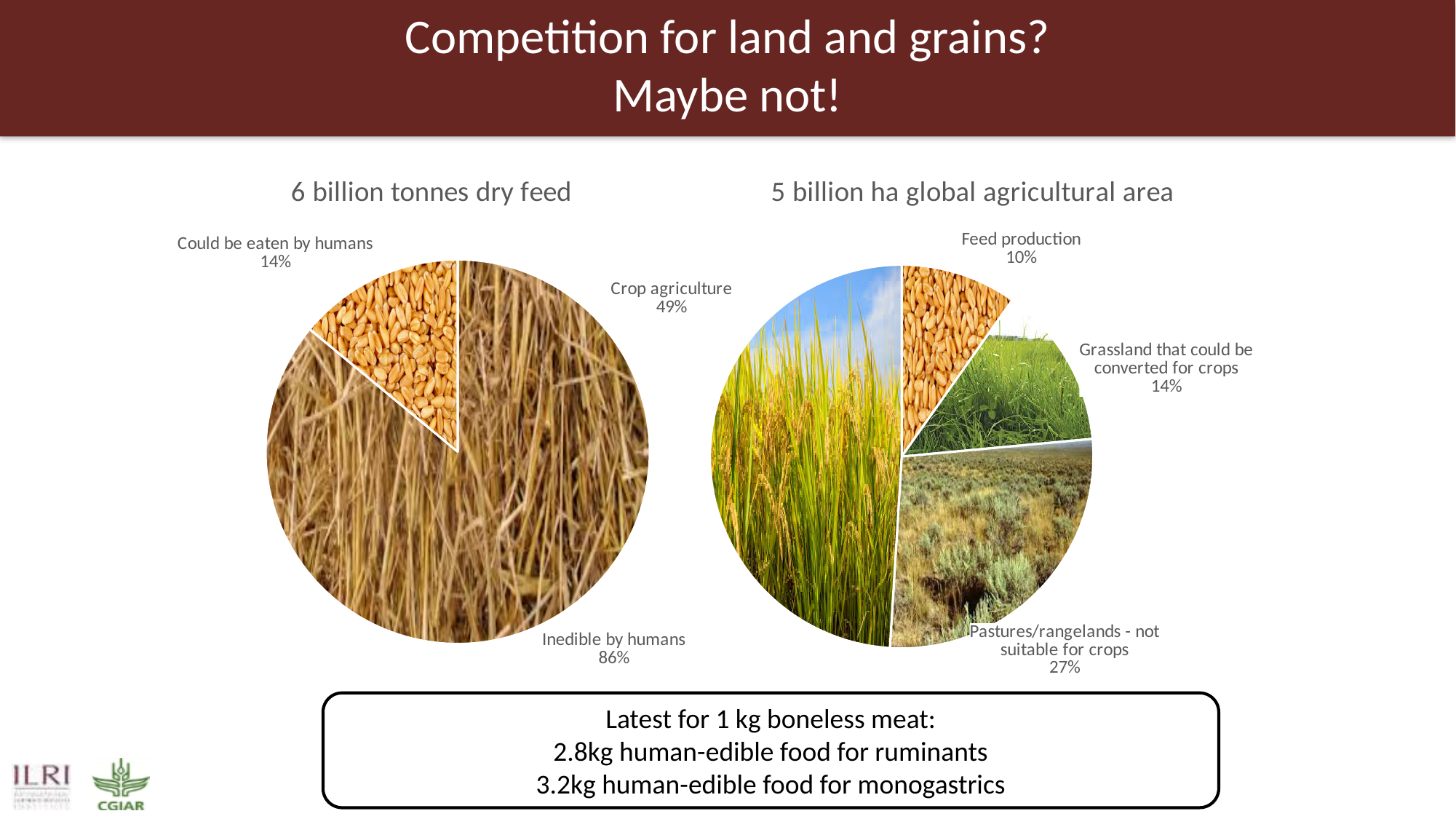
In the "5 billion ha global agricultural area" chart, what share is "Crop agriculture"? 49% In the "6 billion tonnes dry feed" chart, how many slices are there? 2 In the "5 billion ha global agricultural area" chart, what share is "Pastures/rangelands - not suitable for crops"? 27% In the "5 billion ha global agricultural area" chart, what share is "Feed production"? 10% In the "5 billion ha global agricultural area" chart, which category has the smallest share? Feed production In the "6 billion tonnes dry feed" chart, what share is "Inedible by humans"? 86% In the "5 billion ha global agricultural area" chart, which is larger: "Grassland that could be converted for crops" or "Pastures/rangelands - not suitable for crops"? Pastures/rangelands - not suitable for crops In the "6 billion tonnes dry feed" chart, what share is "Could be eaten by humans"? 14% In the "6 billion tonnes dry feed" chart, what is the difference between the "Inedible by humans" and "Could be eaten by humans" shares? 72% In the "5 billion ha global agricultural area" chart, which category has the largest share? Crop agriculture What kind of chart is the "6 billion tonnes dry feed" chart? Pie chart In the "5 billion ha global agricultural area" chart, how many slices are there? 4